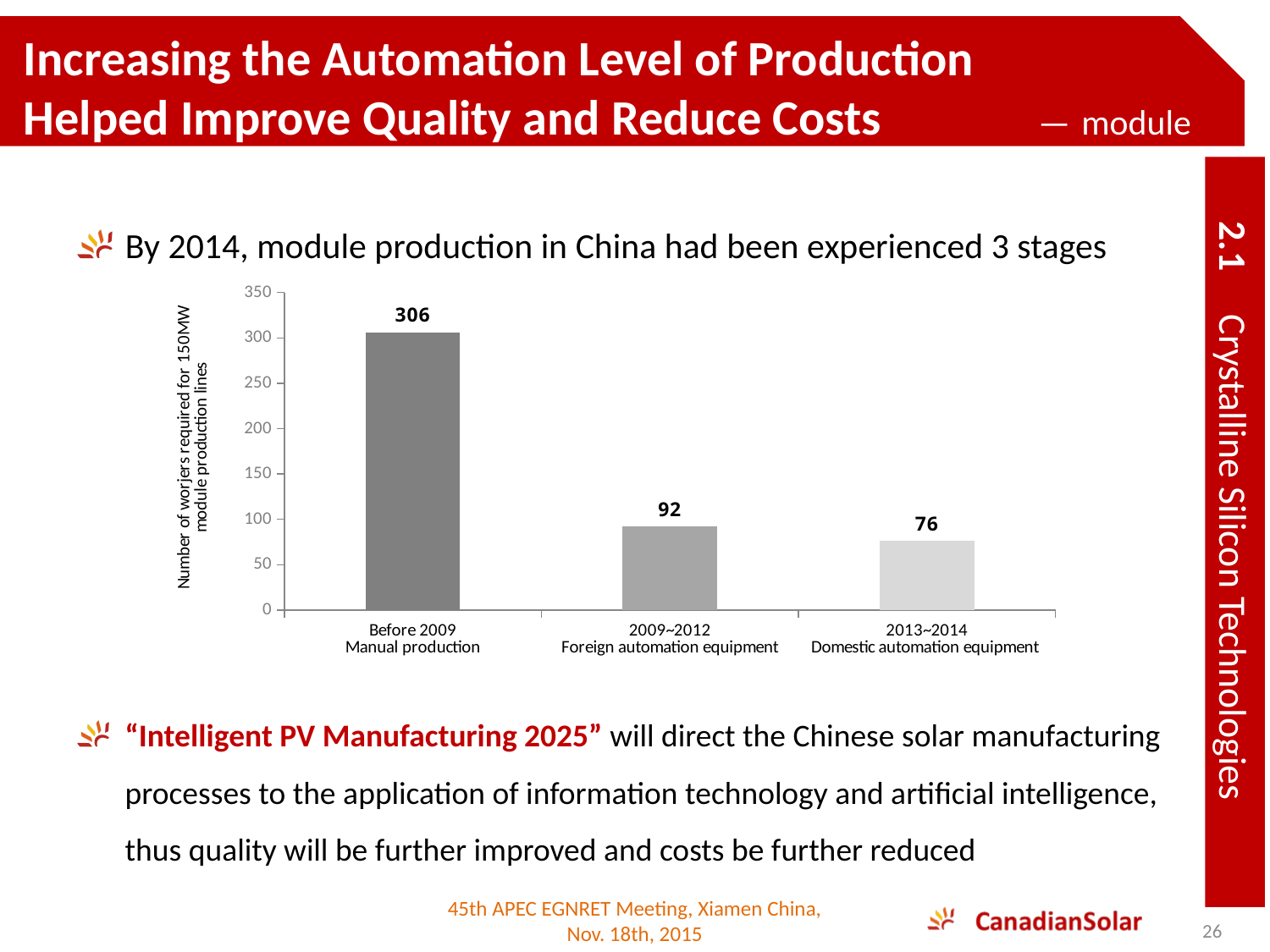
How many categories are shown in the chart? 3 What is the value for 2009~2012 Foreign automation equipment? 92 What kind of chart is shown on the slide? bar chart Which category has the lowest number of workers required? 2013~2014 Domestic automation equipment What is the value for 2013~2014 Domestic automation equipment? 76 Is the value for Before 2009 Manual production greater or less than 300? greater What is the difference between the values for 2009~2012 and 2013~2014? 16 Do the values rise or fall from left to right along the x axis? fall What is the difference between the values for Before 2009 and 2013~2014? 230 What is the number of workers required for 150MW module production lines for Before 2009 Manual production? 306 Which category has the highest number of workers required? Before 2009 Manual production Which is larger, the value for 2009~2012 Foreign automation equipment or 2013~2014 Domestic automation equipment? 2009~2012 Foreign automation equipment